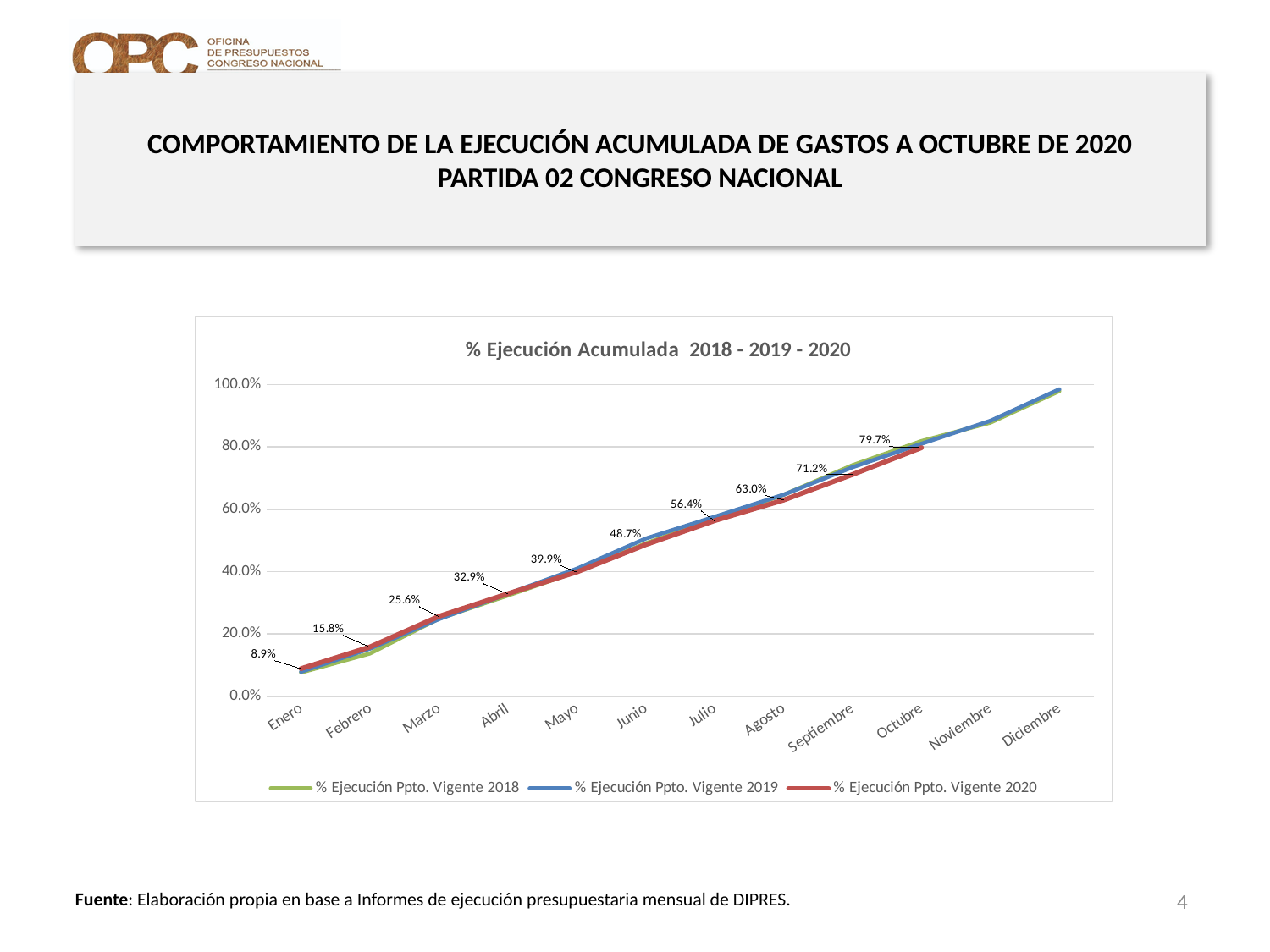
Do the values for % Ejecución Ppto. Vigente 2020 rise or fall from Enero to Octubre? rise What is the value labelled for % Ejecución Ppto. Vigente 2020 in Octubre? 79.7% Is the value for % Ejecución Ppto. Vigente 2019 in Diciembre greater or less than 80.0%? greater What is the value labelled for % Ejecución Ppto. Vigente 2020 in Junio? 48.7% What kind of chart is shown on the slide? line chart What is the value labelled for % Ejecución Ppto. Vigente 2020 in Enero? 8.9% What is the title of the chart? % Ejecución Acumulada 2018 - 2019 - 2020 What is the difference between the labelled 2020 values for Febrero and Enero? 6.9% What is the difference between the labelled 2020 values for Octubre and Septiembre? 8.5% How many months are shown on the x axis? 12 What is the value labelled for % Ejecución Ppto. Vigente 2020 in Marzo? 25.6% How many series does the legend list? 3